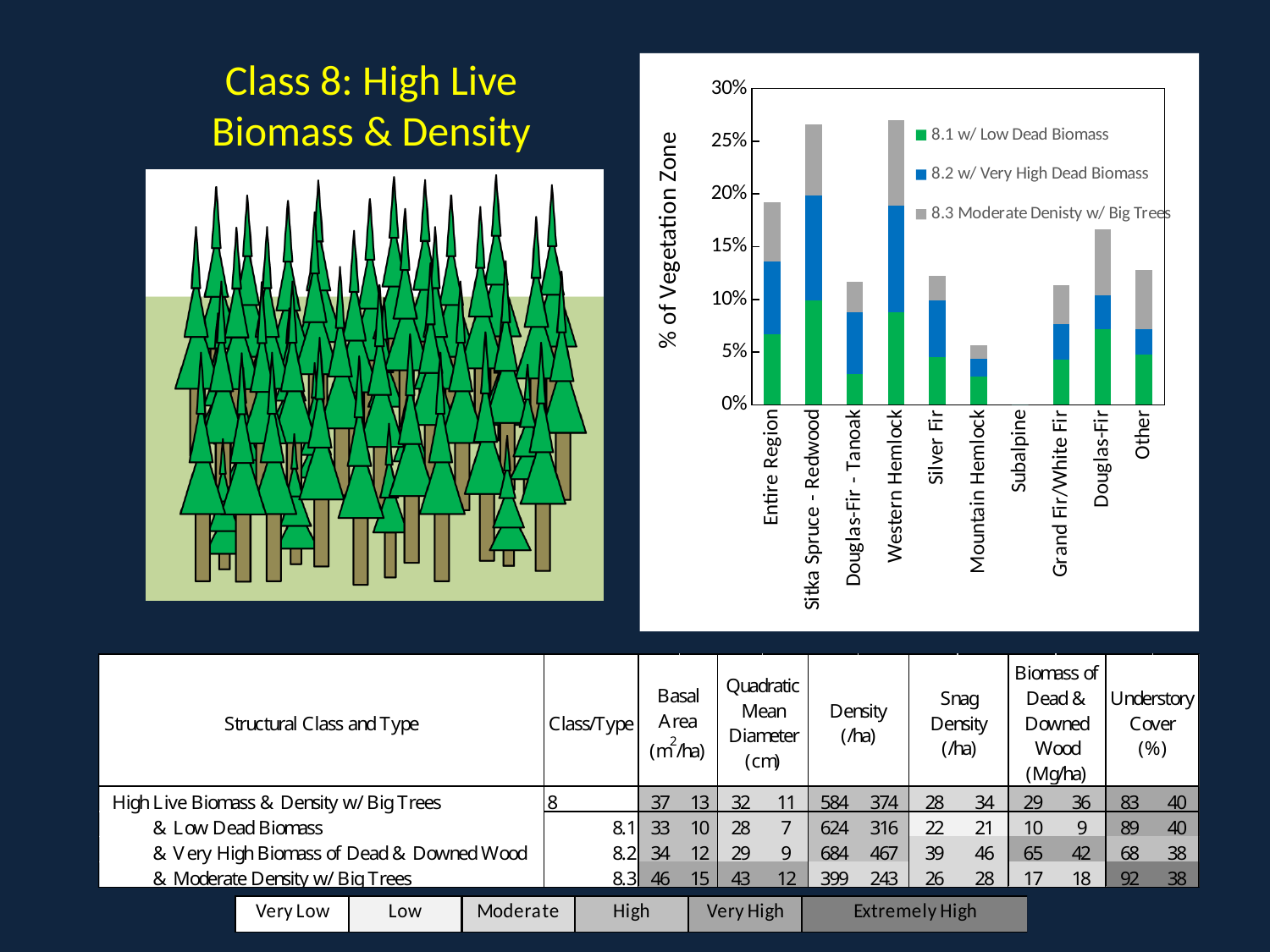
Which has the larger total bar, Silver Fir or Mountain Hemlock? Silver Fir Is the total bar for Sitka Spruce - Redwood greater or less than 25%? greater What is the label on the chart's vertical axis? % of Vegetation Zone Which has the larger total bar, Entire Region or Douglas-Fir? Entire Region What kind of chart is shown on the slide? stacked bar chart Which vegetation zone has the lowest total bar in the chart? Subalpine How many vegetation zone categories are shown on the x axis of the chart? 10 Is the total bar for Mountain Hemlock greater or less than 10%? less Which legend entry is shown in green in the chart? 8.1 w/ Low Dead Biomass Is the total bar for Entire Region greater or less than 15%? greater How many series does the chart's legend list? 3